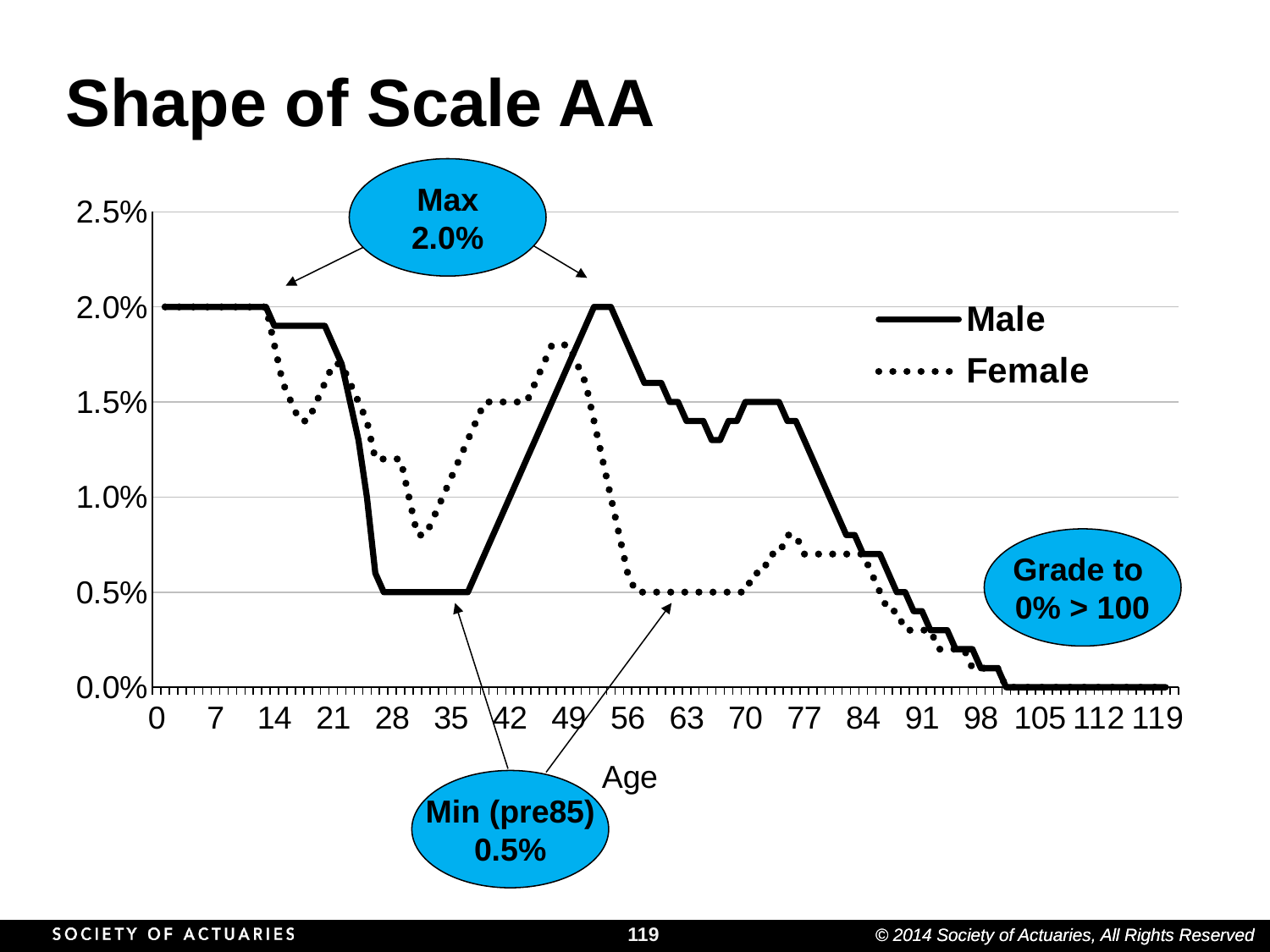
What is the title of the chart? Shape of Scale AA What kind of chart is shown on the slide? line chart Is the Female value at age 49 greater or less than 1.5%? greater What is the Male value at age 28? 0.5% How many series does the legend list? 2 What is the maximum value of Scale AA according to the callout? 2.0% Does the Male line rise or fall between age 84 and age 105? fall What is the minimum value of Scale AA before age 85 according to the callout? 0.5% What are the two series named in the legend? Male and Female What is the Male value at age 0? 2.0% At age 63, which series has the higher value, Male or Female? Male Is the Female value at age 77 greater or less than 1.0%? less